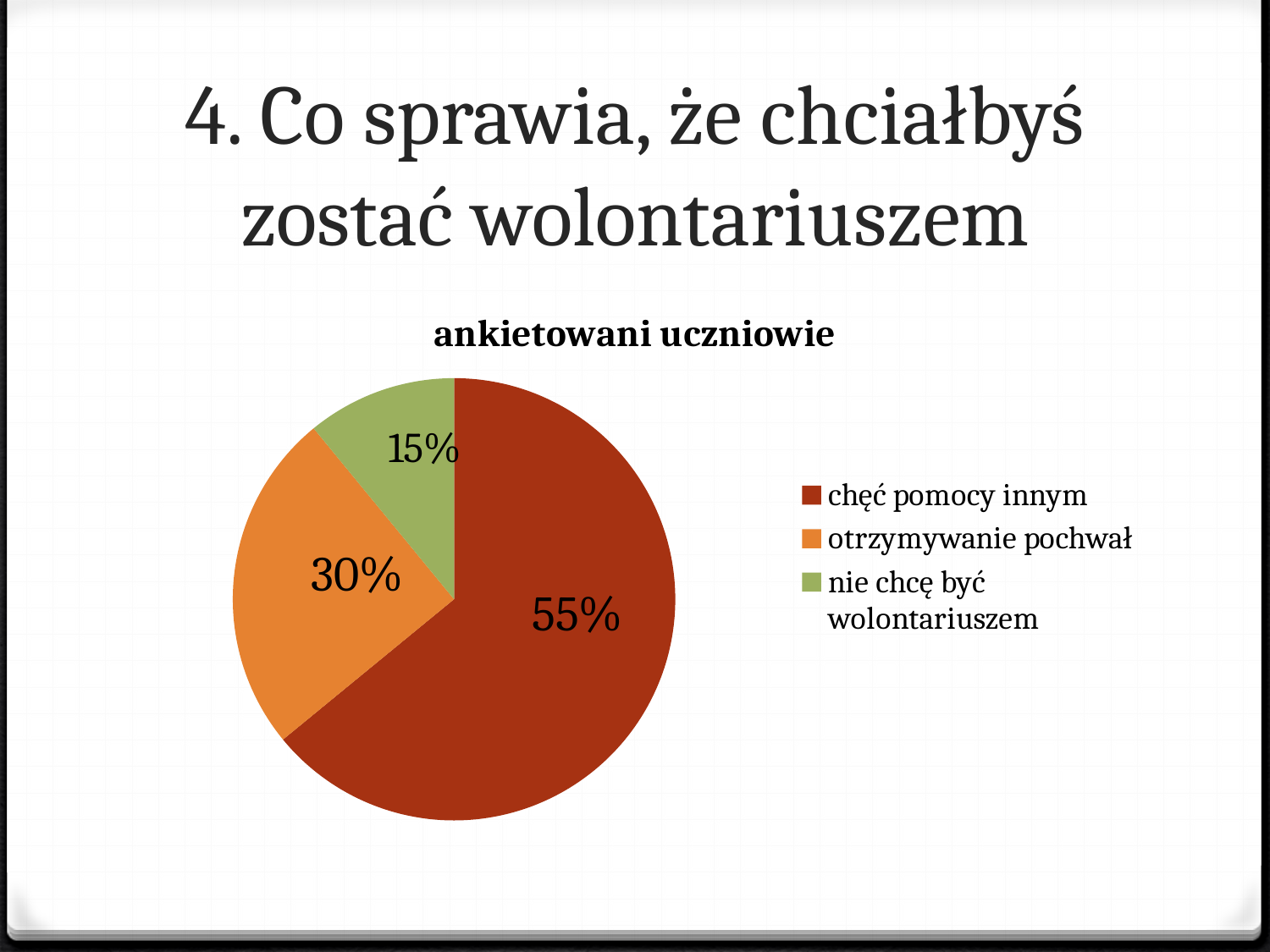
What percentage of the pie is labelled for "nie chcę być wolontariuszem"? 15% What percentage of the pie is labelled for "chęć pomocy innym"? 55% What percentage of the pie is labelled for "otrzymywanie pochwał"? 30% What kind of chart is shown on the slide? pie chart Which category has the smallest slice of the pie? nie chcę być wolontariuszem Which category has the largest slice of the pie? chęć pomocy innym What is the difference in percentage points between "chęć pomocy innym" and "otrzymywanie pochwał"? 25 How many slices does the pie chart have? 3 Which is larger: the slice for "otrzymywanie pochwał" or the slice for "nie chcę być wolontariuszem"? otrzymywanie pochwał What is the difference in percentage points between "otrzymywanie pochwał" and "nie chcę być wolontariuszem"? 15 What colour is the slice for "nie chcę być wolontariuszem"? green What is the title of the chart? ankietowani uczniowie